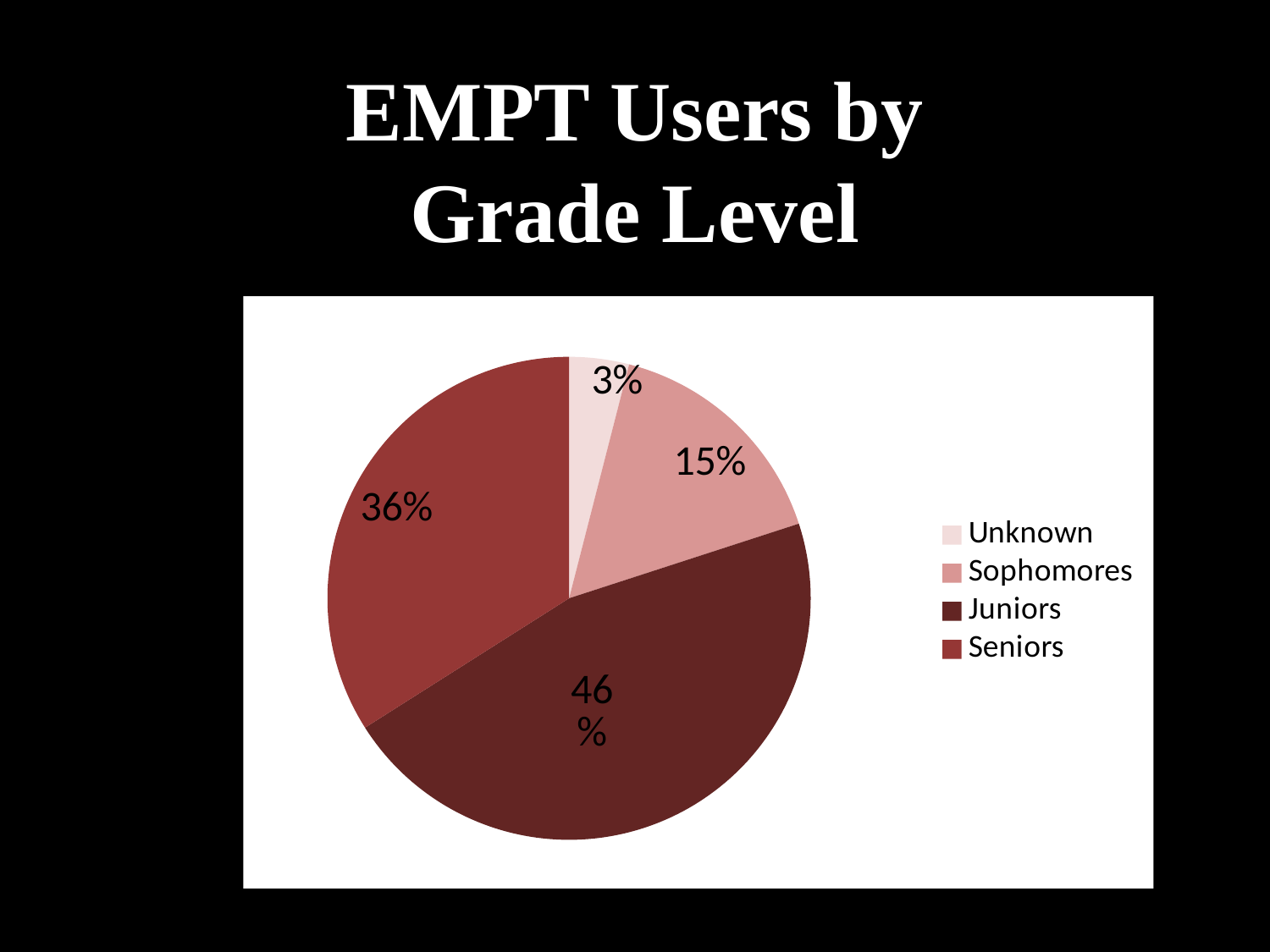
How many categories does the pie chart show? 4 Which category has the smallest share of EMPT users? Unknown What share of EMPT users are Juniors? 46% What share of EMPT users are Sophomores? 15% Which grade level has the largest share of EMPT users? Juniors What share of EMPT users have an Unknown grade level? 3% What is the title of the slide? EMPT Users by Grade Level What is the difference in percentage points between the Juniors and Seniors shares? 10 Which legend entry is shown with the lightest colour? Unknown What share of EMPT users are Seniors? 36% What kind of chart is shown on the slide? pie chart Which has a larger share of EMPT users, Sophomores or Seniors? Seniors